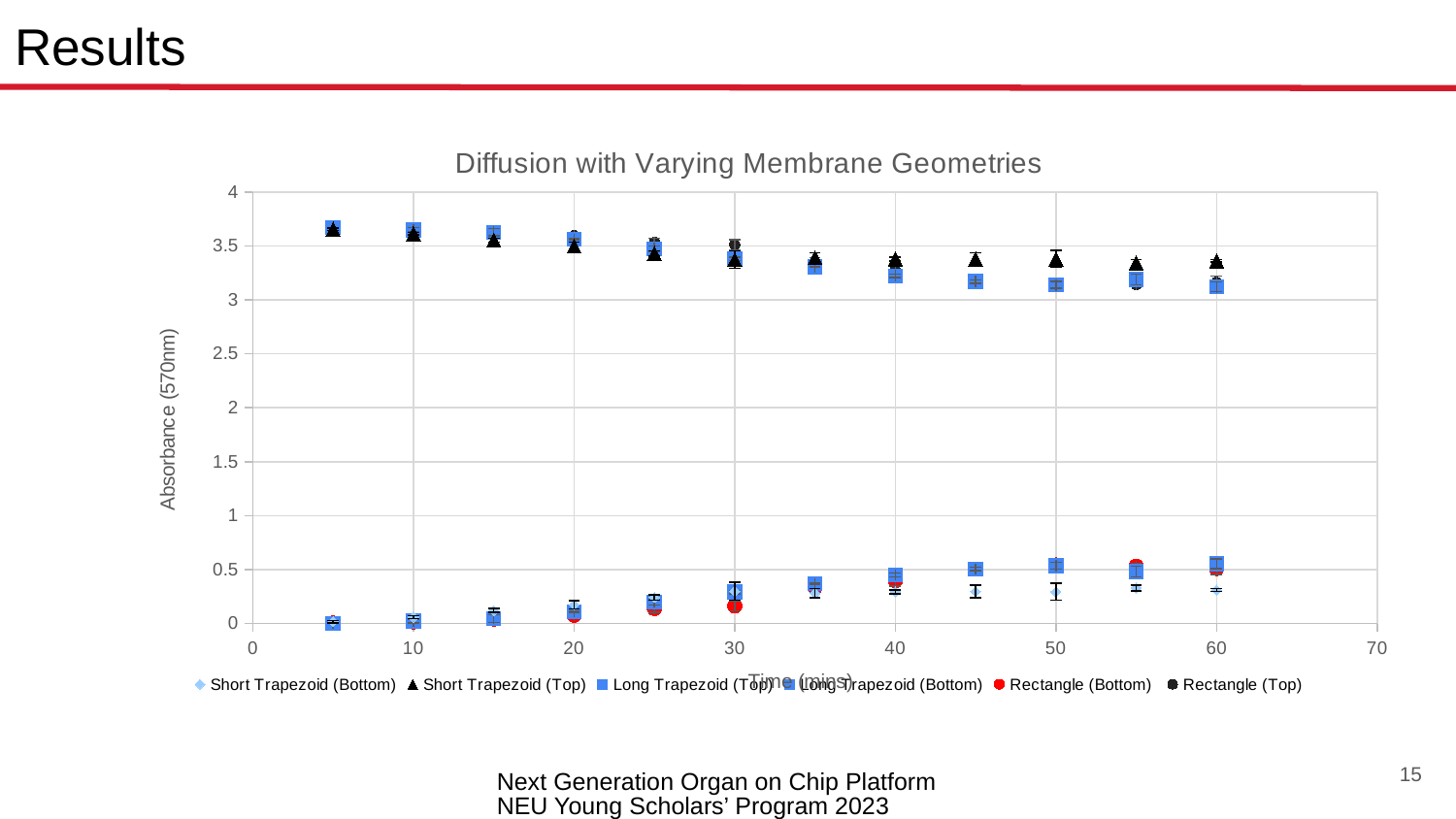
Is the value for Long Trapezoid (Top) at 60 minutes greater or less than 3? less Do the values for Long Trapezoid (Bottom) rise or fall as time increases? Fall How many time points are plotted for each series? 12 How many series does the chart's legend list? 6 Do the values for Short Trapezoid (Top) rise or fall as time increases? Fall What is the label of the y axis? Absorbance (570nm) Is the value for Long Trapezoid (Bottom) at 60 minutes greater or less than 1? greater Is the value for Short Trapezoid (Top) at 5 minutes greater or less than 3.5? greater At 60 minutes, which is larger: Short Trapezoid (Top) or Long Trapezoid (Top)? Short Trapezoid (Top) What is the title of the chart? Diffusion with Varying Membrane Geometries What kind of chart is shown on the slide? Scatter chart